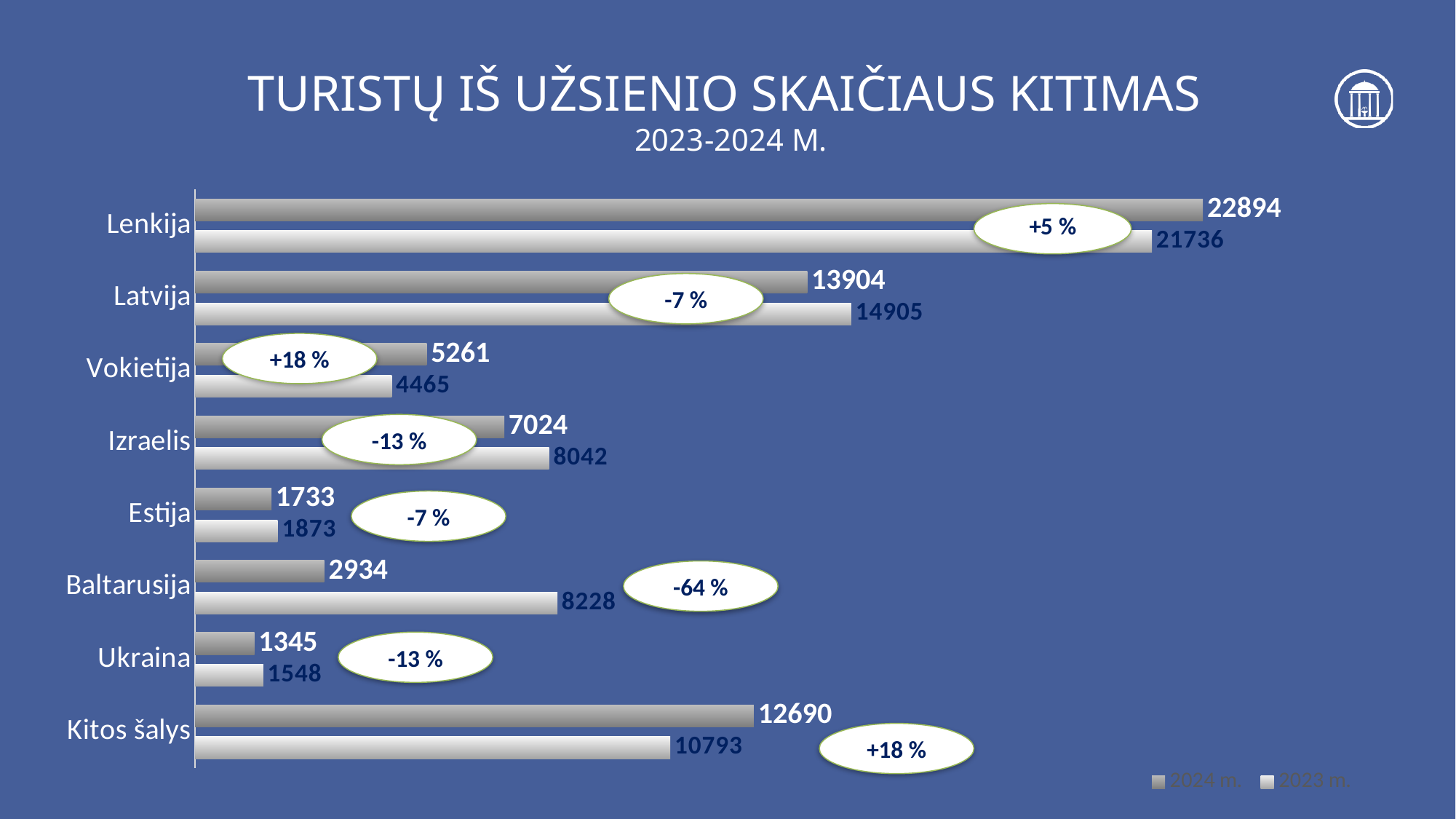
What kind of chart is shown on the slide? Bar chart Which is larger for Izraelis, the 2024 m. value or the 2023 m. value? 2023 m. How many series does the legend list? 2 What percentage change is shown for Baltarusija? -64 % What is the 2024 m. value for Lenkija? 22894 How many categories are shown on the chart? 8 What is the 2023 m. value for Baltarusija? 8228 What is the 2024 m. value for Vokietija? 5261 Which category has the highest 2024 m. value? Lenkija Which category has the lowest 2024 m. value? Ukraina What is the difference between the 2024 m. and 2023 m. values for Latvija? 1001 What is the title of the chart? TURISTŲ IŠ UŽSIENIO SKAIČIAUS KITIMAS 2023-2024 M.